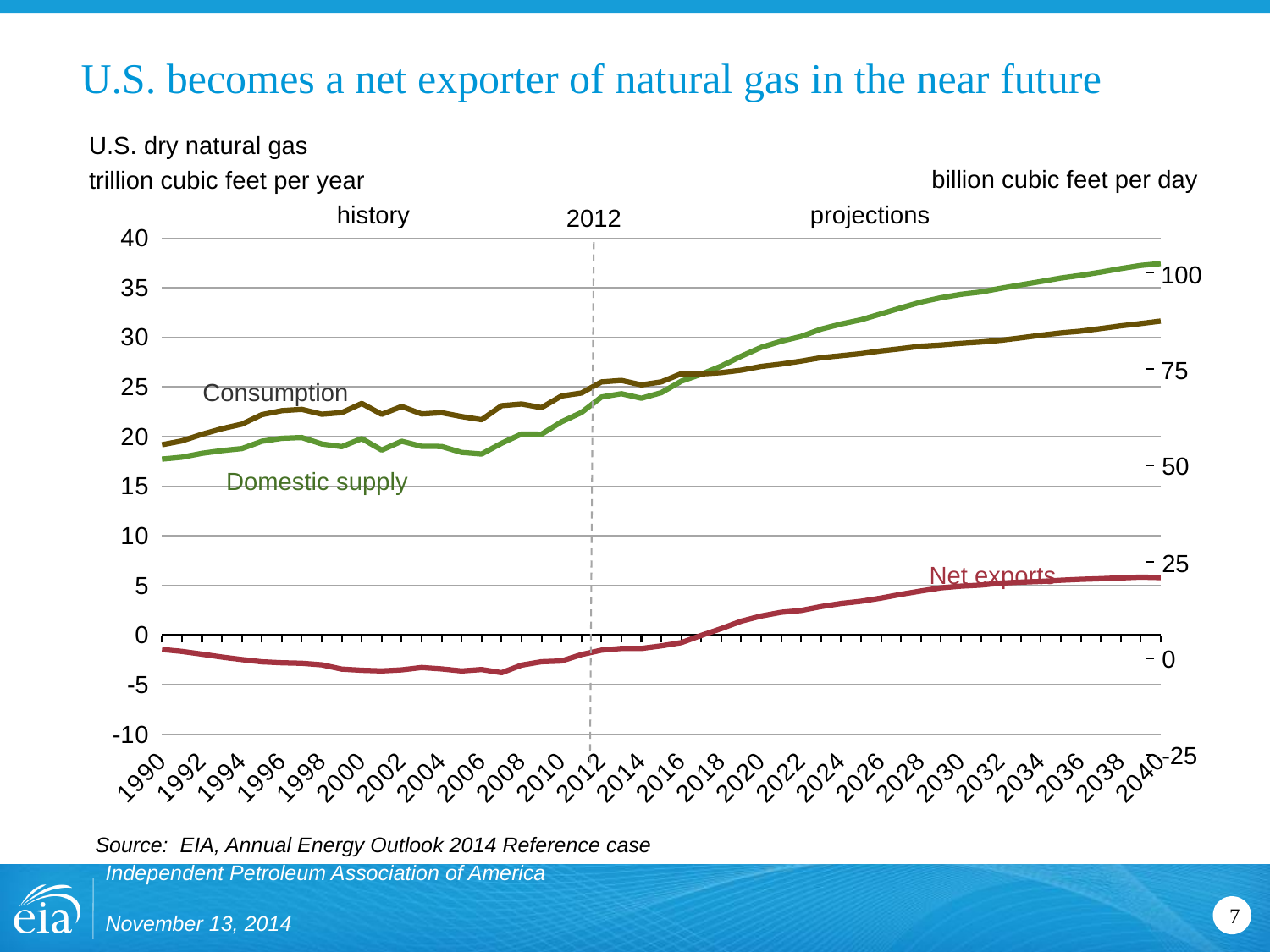
How many data series are plotted on the chart? 3 What unit is shown on the left vertical axis of the chart? trillion cubic feet per year Which series is higher in 2040, Consumption or Domestic supply? Domestic supply Is the value for Net exports in 1990 greater or less than 0? less Is the value for Consumption in 2040 greater or less than 30 trillion cubic feet per year? greater What kind of chart is shown on the slide? line chart Is the value for Consumption in 1990 greater or less than 20 trillion cubic feet per year? less Which year does the dashed vertical line separating history from projections mark? 2012 Which series is higher in 1990, Consumption or Domestic supply? Consumption Do Net exports rise or fall between 2012 and 2040? rise